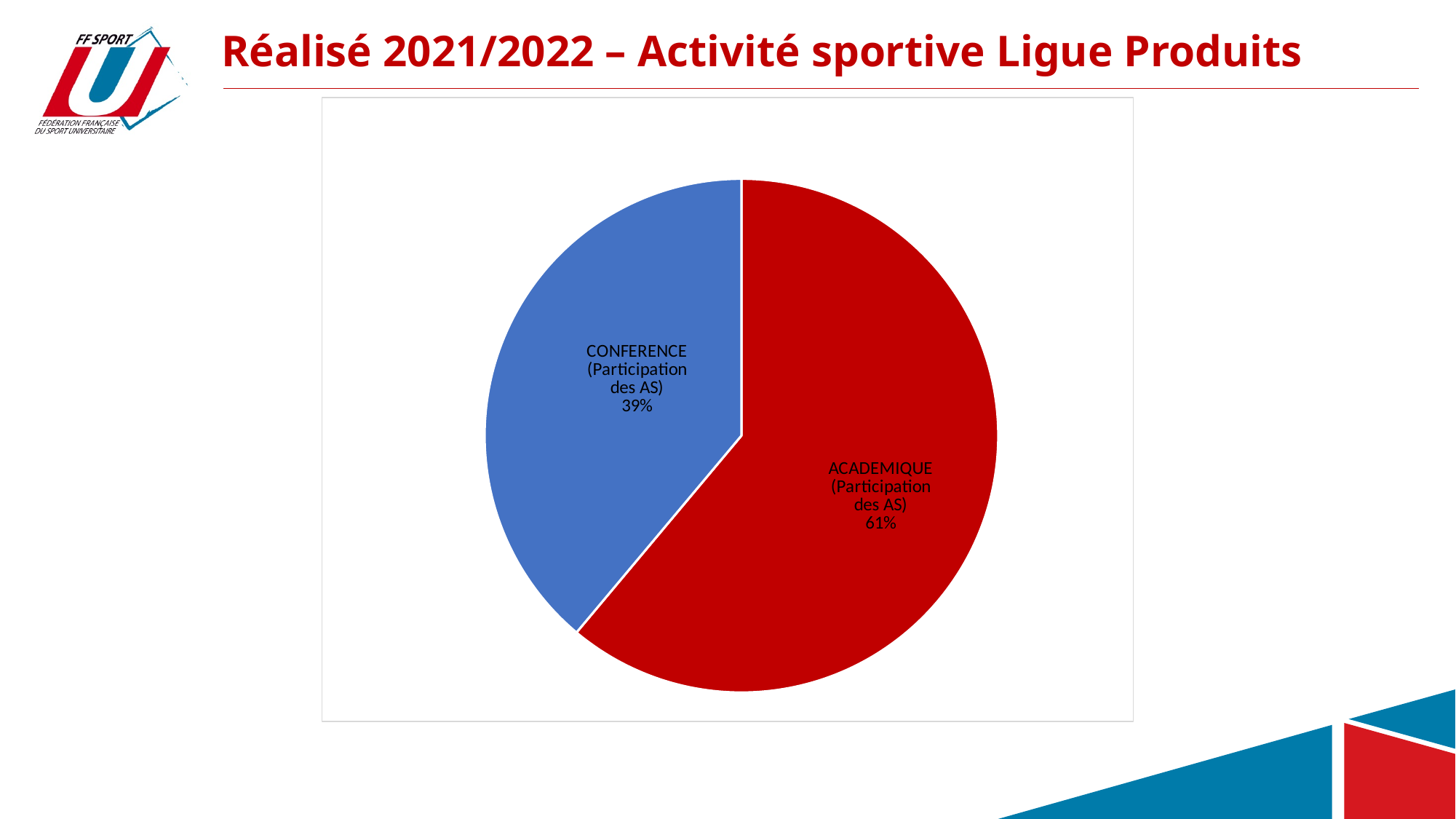
Is the share for CONFERENCE (Participation des AS) greater or less than 50%? less What share of the pie does CONFERENCE (Participation des AS) represent? 39% What kind of chart is shown on the slide? pie chart How many slices does the pie chart have? 2 Which slice of the pie is the smallest? CONFERENCE (Participation des AS) Which is larger, the ACADEMIQUE slice or the CONFERENCE slice? ACADEMIQUE Which slice of the pie is the largest? ACADEMIQUE (Participation des AS) What share of the pie does ACADEMIQUE (Participation des AS) represent? 61% What colour is the ACADEMIQUE (Participation des AS) slice? red What is the difference in percentage points between the ACADEMIQUE and CONFERENCE slices? 22 What colour is the CONFERENCE (Participation des AS) slice? blue